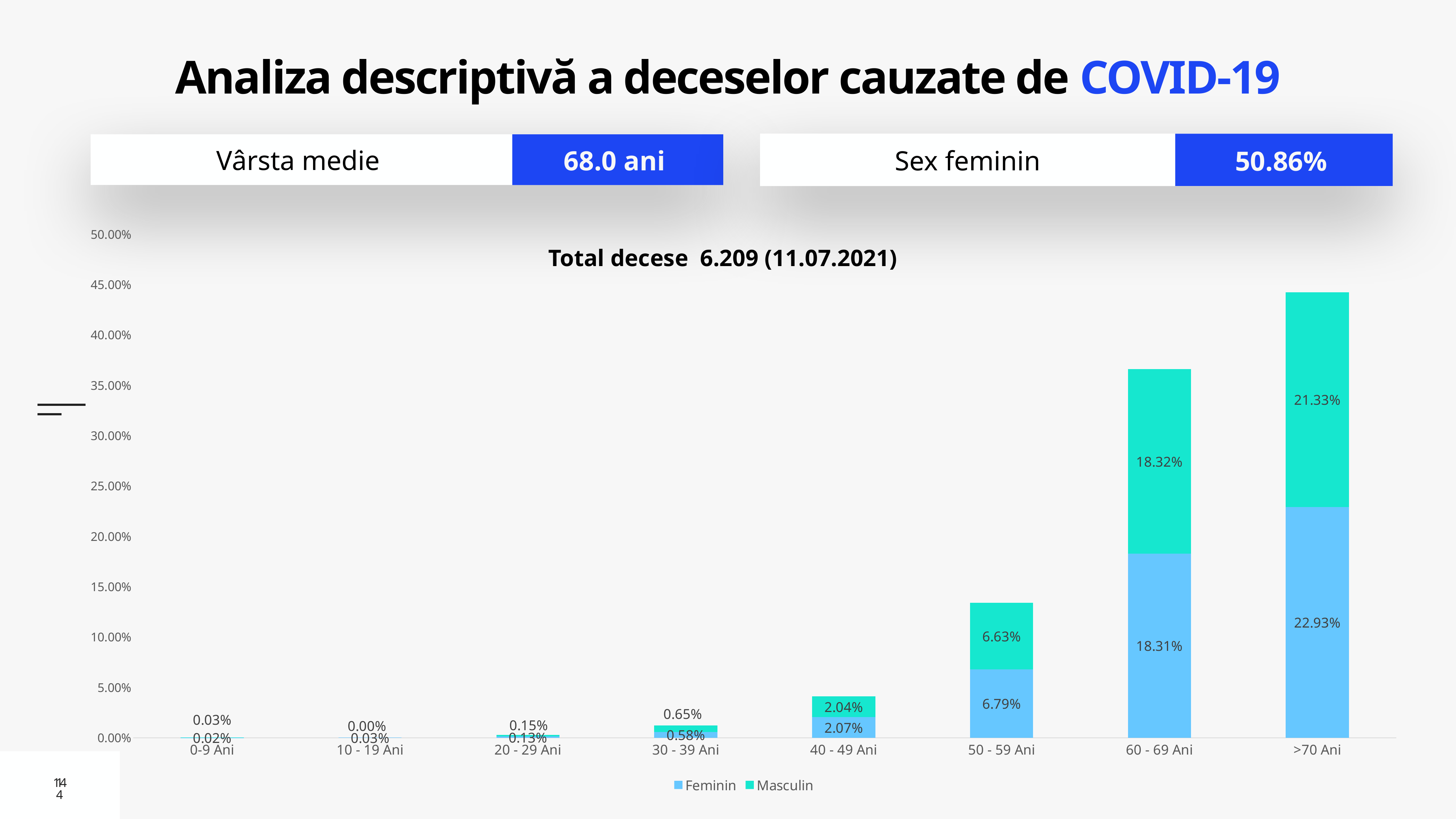
What is the Masculin value for the 40 - 49 Ani age group? 2.04% How many series does the legend list? 2 How many age groups are shown on the x axis? 8 Is the total stacked bar for the 60 - 69 Ani age group greater or less than 35.00%? greater Which age group has the highest Feminin value? >70 Ani What is the Feminin value for the >70 Ani age group? 22.93% What is the total of the stacked bar for the 50 - 59 Ani age group? 13.42% What is the Feminin value for the 50 - 59 Ani age group? 6.79% What kind of chart is shown on the slide? Stacked bar chart Which age group has the lowest Masculin value? 10 - 19 Ani What is the Masculin value for the 60 - 69 Ani age group? 18.32% What is the difference between the Feminin and Masculin values for the >70 Ani age group? 1.60%